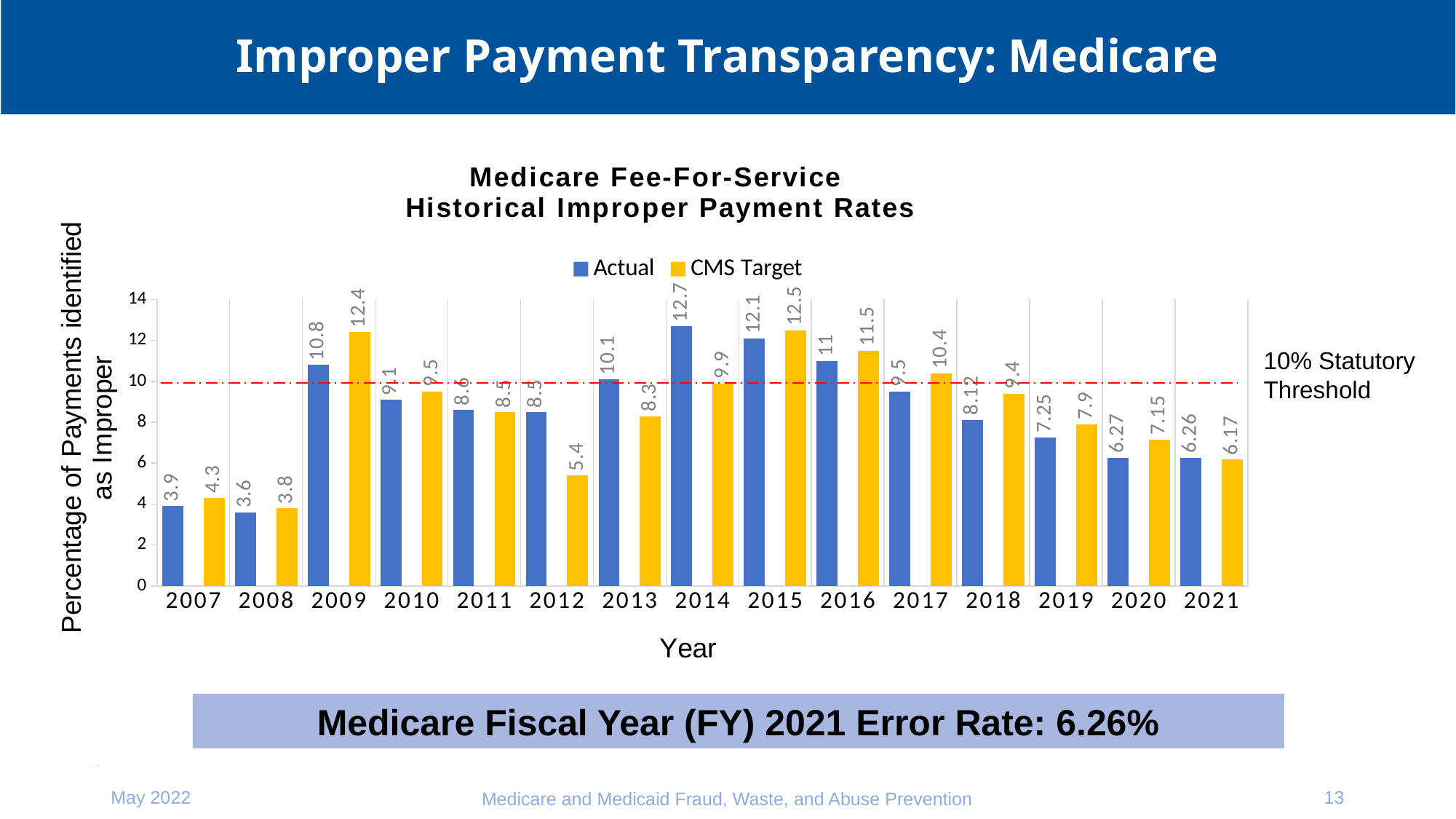
What is the Actual improper payment rate for 2014? 12.7 What kind of chart is shown on the slide? Bar chart Which year has the lowest Actual improper payment rate? 2008 What is the CMS Target value for 2009? 12.4 What is the difference between the Actual value and the CMS Target value for 2012? 3.1 Which year has the highest CMS Target value? 2015 Which year has the highest Actual improper payment rate? 2014 How many series does the legend list? 2 What is the Actual value for 2021? 6.26 Which is larger for 2017, the Actual value or the CMS Target value? CMS Target How many years are shown on the x axis? 15 What does the red dashed horizontal line represent? 10% Statutory Threshold